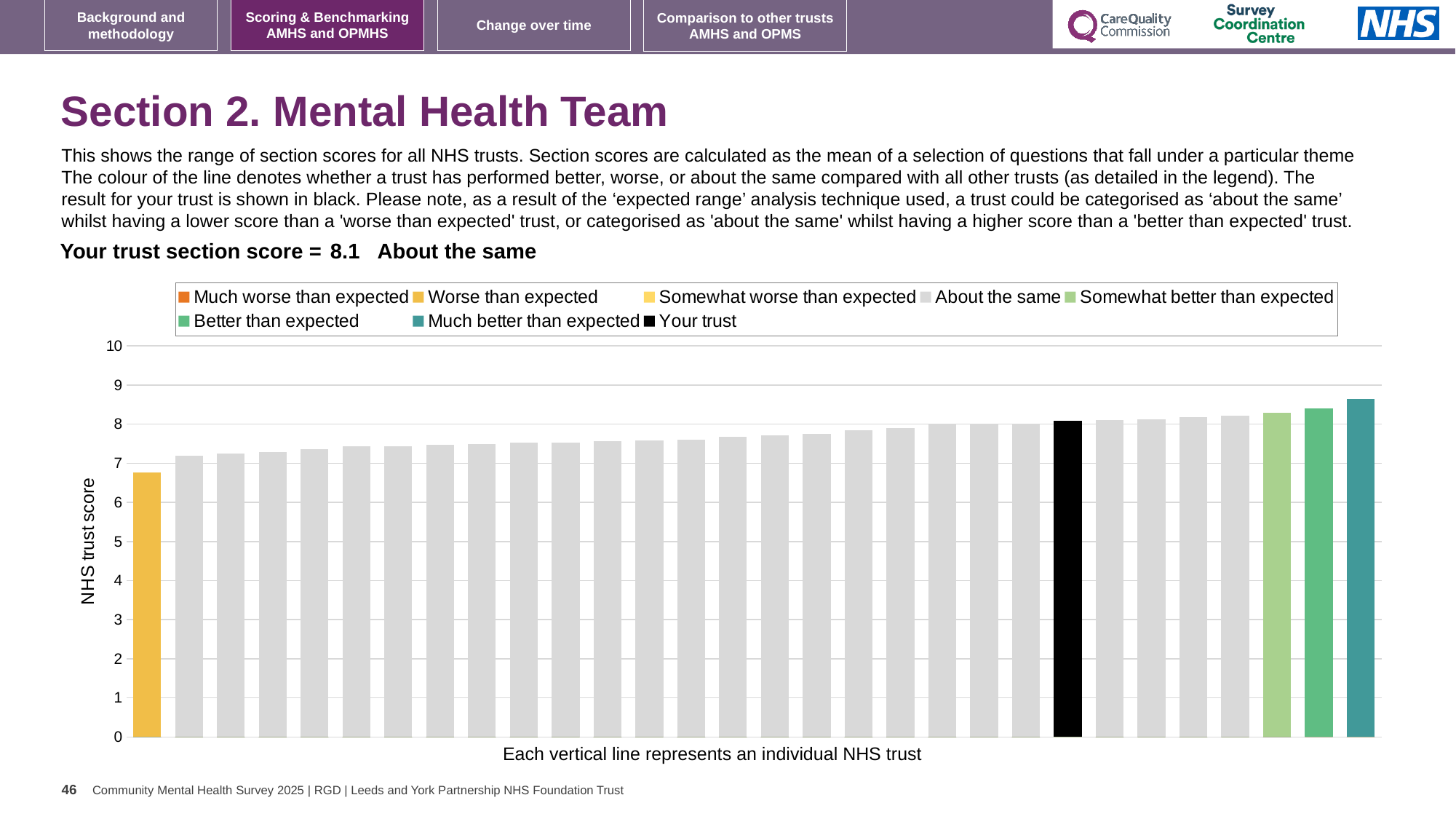
What is the section score for your trust shown on the slide? 8.1 Which legend category does the shortest bar in the chart belong to? Worse than expected Which legend category does the tallest bar in the chart belong to? Much better than expected What kind of chart is shown on the slide? Bar chart Is the value of the 'Much better than expected' bar greater or less than 8? greater How many entries does the chart legend list? 8 What is the label on the vertical axis of the chart? NHS trust score Which category is your trust placed in for this section? About the same Is the value of the 'Much better than expected' bar greater or less than 9? less Is the value of the 'Worse than expected' bar greater or less than 7? less Which is larger: the 'Your trust' bar or the 'Worse than expected' bar? Your trust Do the bar values rise or fall from left to right across the chart? Rise